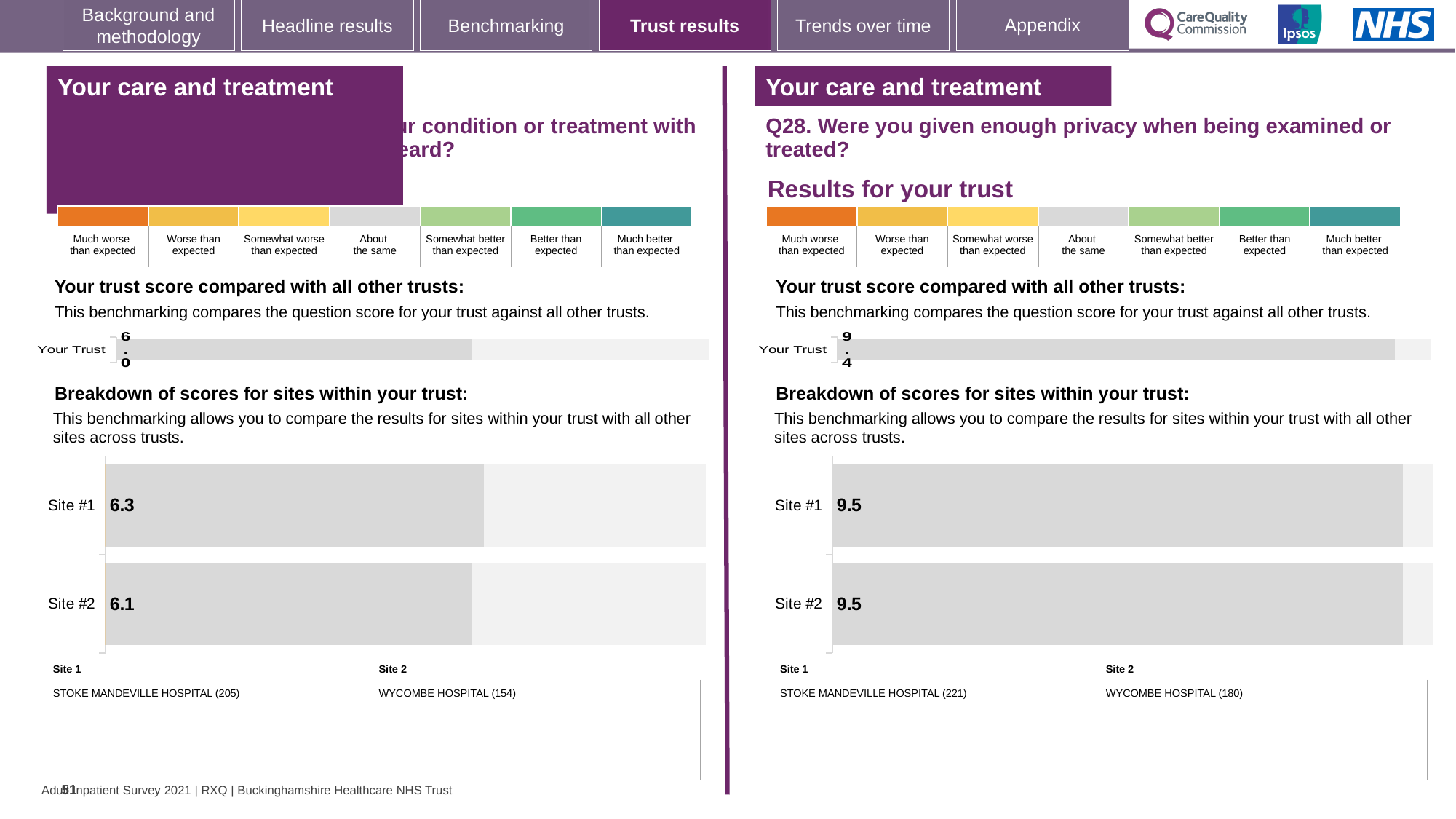
On the right-hand Q28 site breakdown chart, how many sites are shown? 2 On the right-hand Q28 site breakdown chart, is the Site #1 score larger than, smaller than, or equal to the Site #2 score? Equal On the left-hand 'Your trust score compared with all other trusts' chart, what is the score for Your Trust? 6.0 On the left-hand site breakdown chart, what is the difference between the Site #1 and Site #2 scores? 0.2 On the right-hand chart for Q28 (privacy when being examined or treated), what is the score for Your Trust? 9.4 Which hospital is listed as Site 1 on the right-hand side of the slide? STOKE MANDEVILLE HOSPITAL (221) What type of chart is used for the site breakdown on the right-hand side of the slide? Bar chart On the right-hand Q28 site breakdown chart, what is the score for Site #2? 9.5 On the left-hand 'Breakdown of scores for sites within your trust' chart, what is the score for Site #2? 6.1 On the right-hand Q28 site breakdown chart, what is the score for Site #1? 9.5 On the left-hand 'Breakdown of scores for sites within your trust' chart, what is the score for Site #1? 6.3 On the left-hand site breakdown chart, which site has the higher score? Site #1